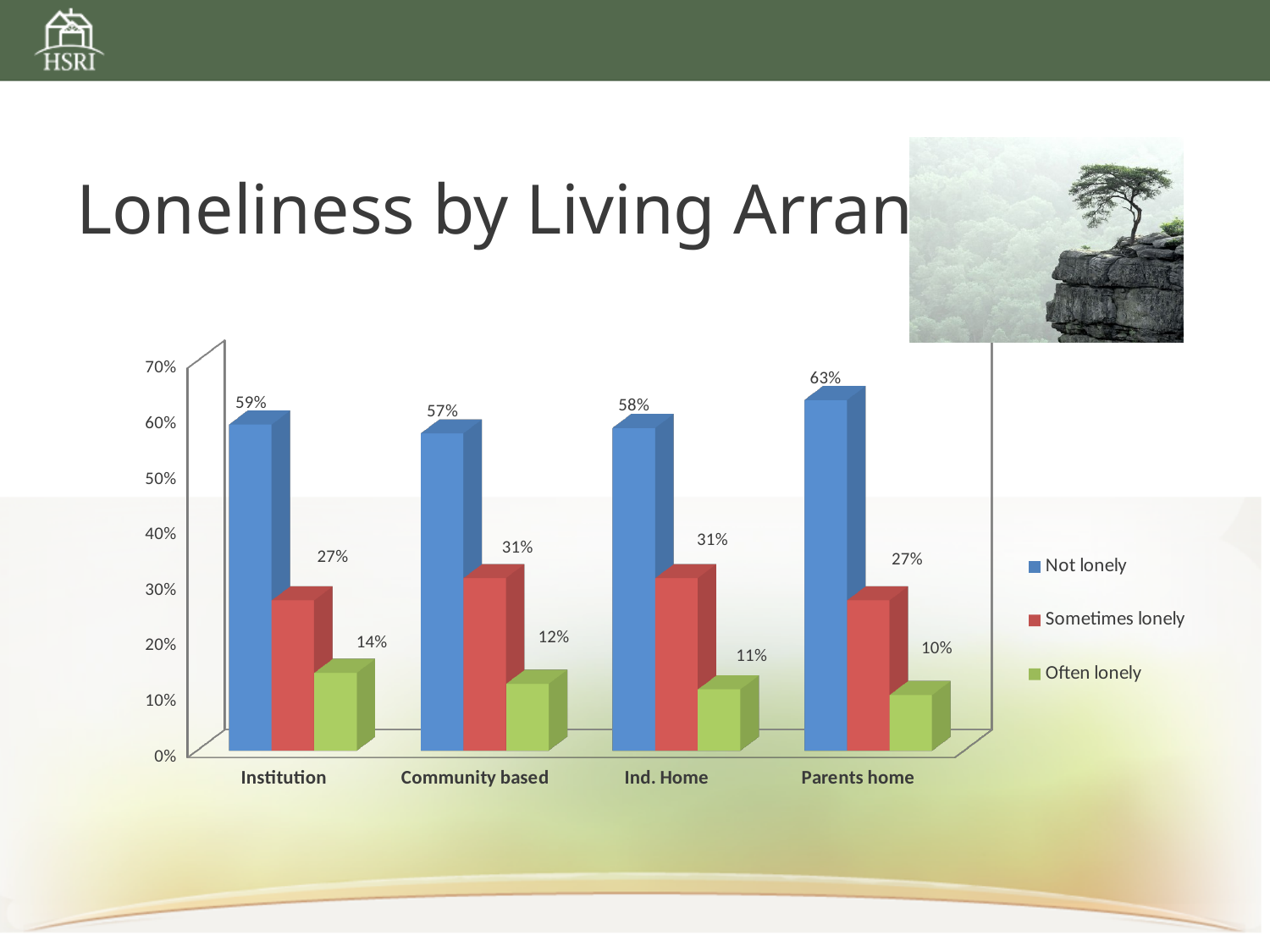
Do the Often lonely values rise or fall from Institution to Parents home along the x axis? Fall What kind of chart is shown on the slide? Bar chart Which category has the lowest value for Often lonely? Parents home Which is larger: the Sometimes lonely value for Ind. Home or for Institution? Ind. Home How many categories are shown on the x axis? 4 Which colour represents the Sometimes lonely series? Red What is the difference between the Not lonely values for Parents home and Community based? 6% What is the value for Sometimes lonely in the Community based category? 31% How many series does the legend list? 3 What is the value for Not lonely in the Parents home category? 63% Which category has the highest value for Not lonely? Parents home What is the value for Often lonely in the Institution category? 14%